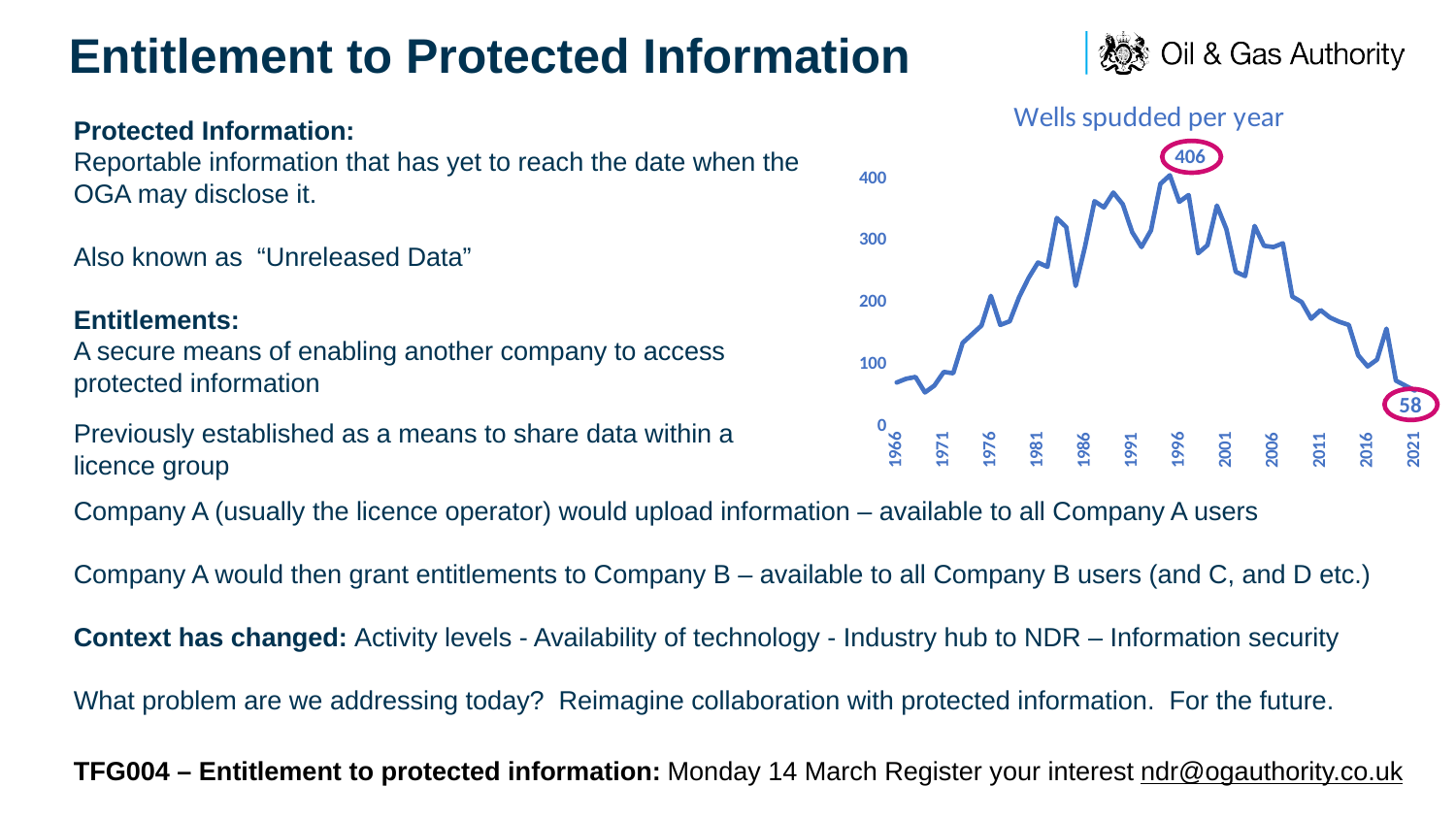
Do the values generally rise or fall between 1996 and 2021? fall What is the value for 2021 on the chart? 58 Is the value for 1966 greater or less than 100? less Is the value for 2011 greater or less than 200? less What is the highest value labelled on the chart? 406 What is the title of the chart? Wells spudded per year What kind of chart is shown on the slide? line chart What is the difference between the peak value of 406 and the 2021 value of 58? 348 Which year has the larger value, 1981 or 2011? 1981 How many year labels are shown on the x axis? 12